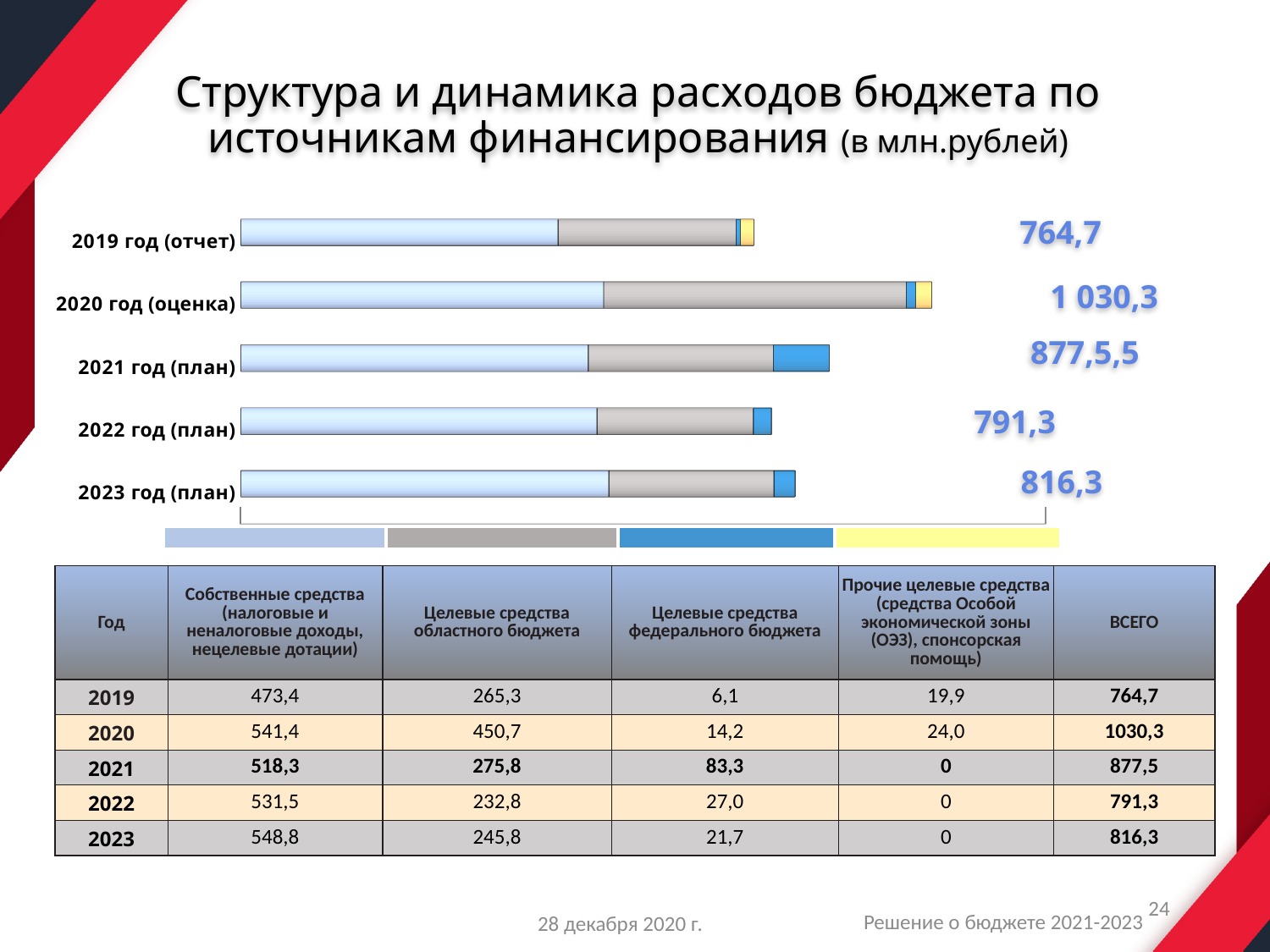
What is the difference between the 2023 total and the 2022 total? 25,0 What kind of chart is shown on the slide? Stacked horizontal bar chart Which total is larger, 2022 год (план) or 2023 год (план)? 2023 год (план) By how much does the 2020 total exceed the 2019 total? 265,6 What total value is printed next to the bar for 2020 год (оценка)? 1 030,3 How many series (colour boxes) does the chart legend show? 4 Which year has the lowest total in the bar chart? 2019 год (отчет) Which year has the highest total in the bar chart? 2020 год (оценка) According to the table, what is the value of Целевые средства федерального бюджета for 2021? 83,3 According to the table, what is the value of Собственные средства for 2023? 548,8 What total value is printed next to the bar for 2019 год (отчет)? 764,7 How many years (categories) are plotted in the bar chart? 5